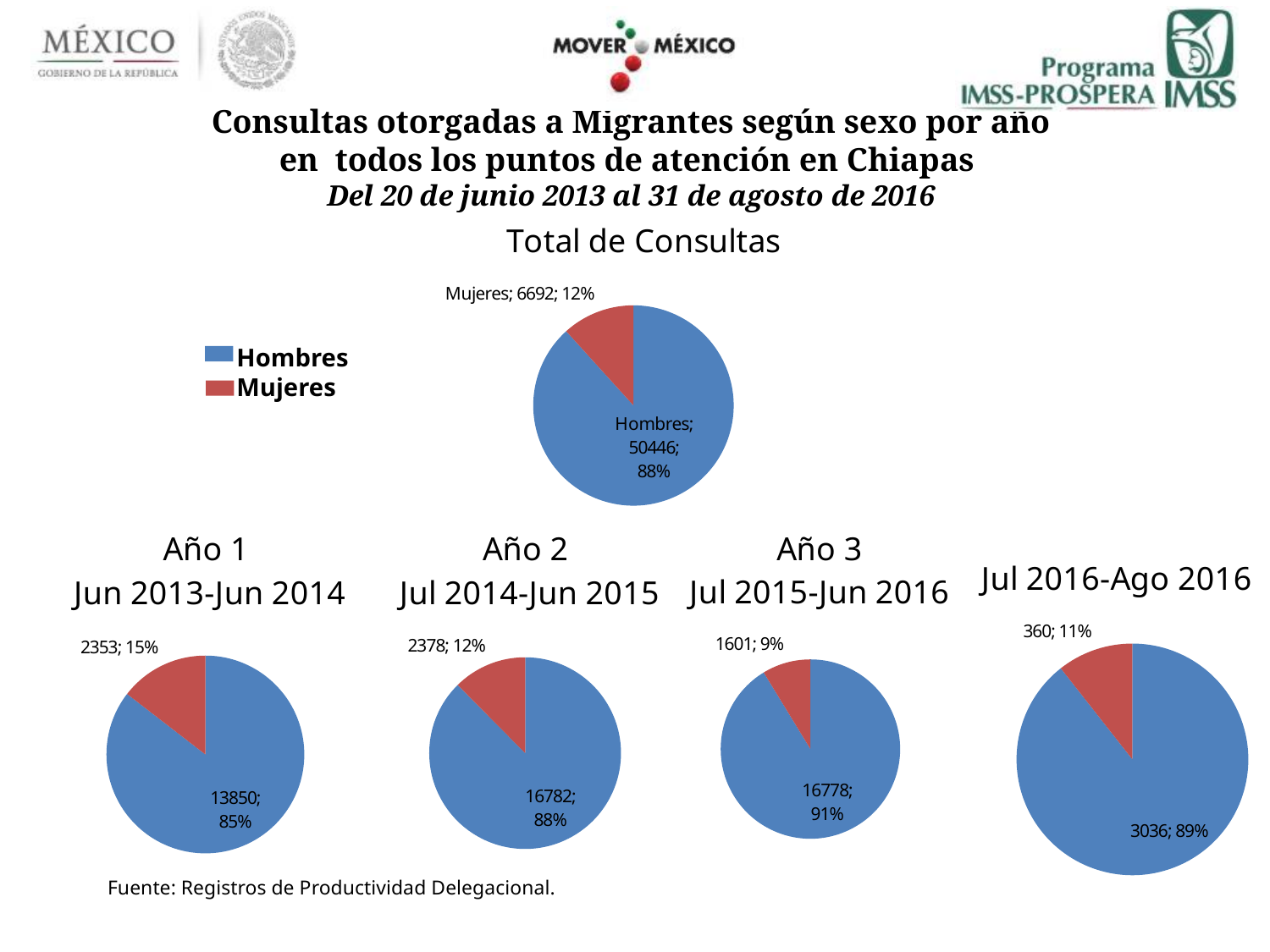
In the 'Año 2 Jul 2014-Jun 2015' pie chart, which slice is larger, Hombres or Mujeres? Hombres In the 'Año 1 Jun 2013-Jun 2014' pie chart, what is the value for Mujeres? 2353 In the 'Año 1 Jun 2013-Jun 2014' pie chart, what share of the pie does Hombres represent? 85% In the 'Jul 2016-Ago 2016' pie chart, what is the value for Hombres? 3036 What kind of chart is used to show 'Total de Consultas'? Pie chart How many series does the legend list? 2 In the 'Total de Consultas' pie chart, what is the value for Hombres? 50446 In the 'Total de Consultas' pie chart, what share of the pie does Mujeres represent? 12% In the 'Total de Consultas' pie chart, what is the value for Mujeres? 6692 In the 'Año 3 Jul 2015-Jun 2016' pie chart, what is the difference between the Hombres and Mujeres values? 15177 In the 'Año 3 Jul 2015-Jun 2016' pie chart, what share of the pie does Mujeres represent? 9% In the 'Año 2 Jul 2014-Jun 2015' pie chart, what is the value for Hombres? 16782